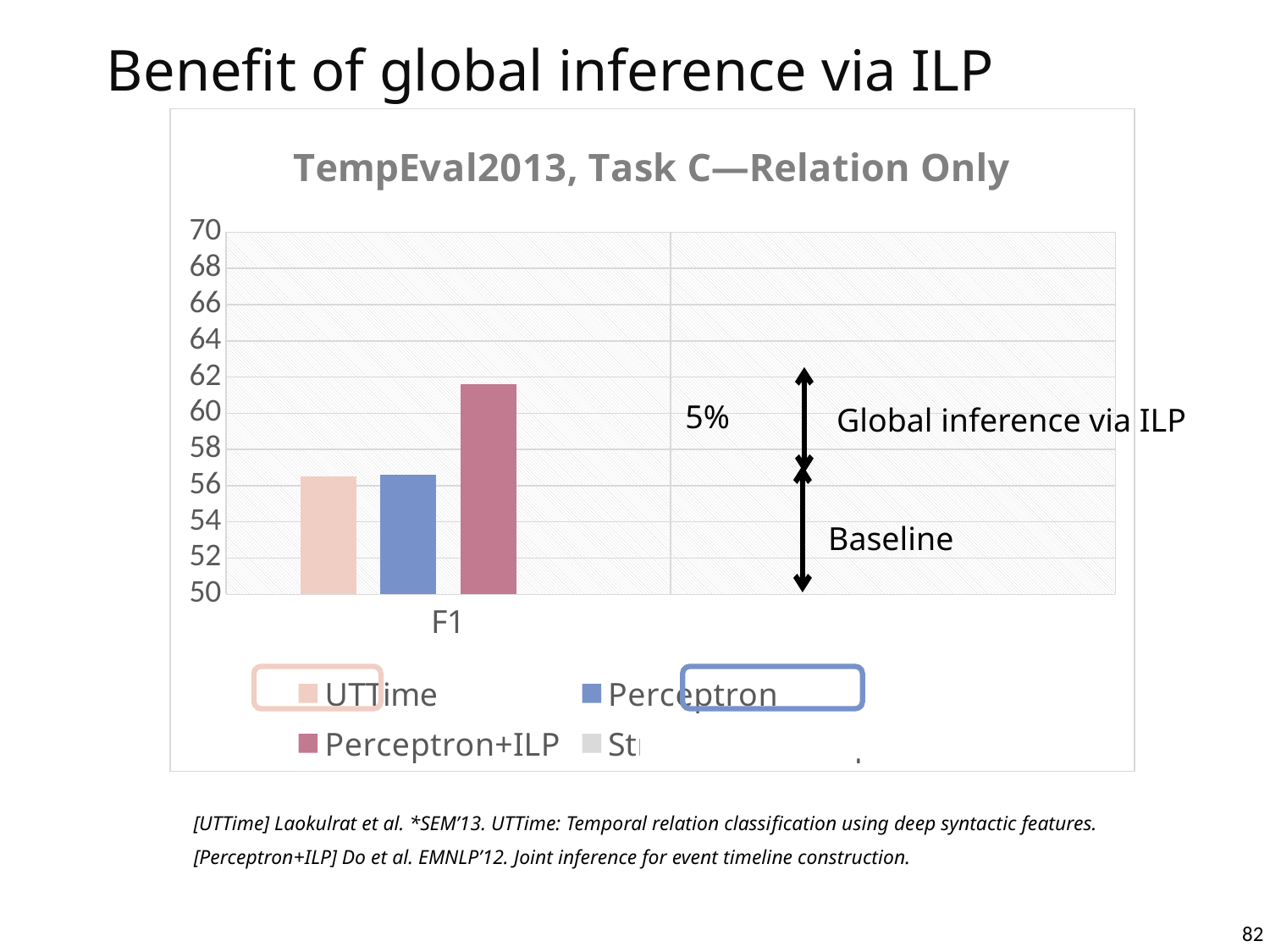
Is the F1 value for Perceptron greater or less than 60? less How many bars are plotted in the chart? 3 Which is larger, the F1 bar for Perceptron or the F1 bar for Perceptron+ILP? Perceptron+ILP Which is larger, the F1 bar for Perceptron+ILP or the F1 bar for UTTime? Perceptron+ILP What percentage improvement is annotated next to the arrow labelled 'Global inference via ILP'? 5% Is the F1 value for Perceptron+ILP greater or less than 60? greater What kind of chart is shown on the slide? bar chart Is the F1 value for UTTime greater or less than 58? less Which series has the highest F1 bar? Perceptron+ILP How many categories are shown on the x axis? 1 What is the title of the chart? TempEval2013, Task C—Relation Only